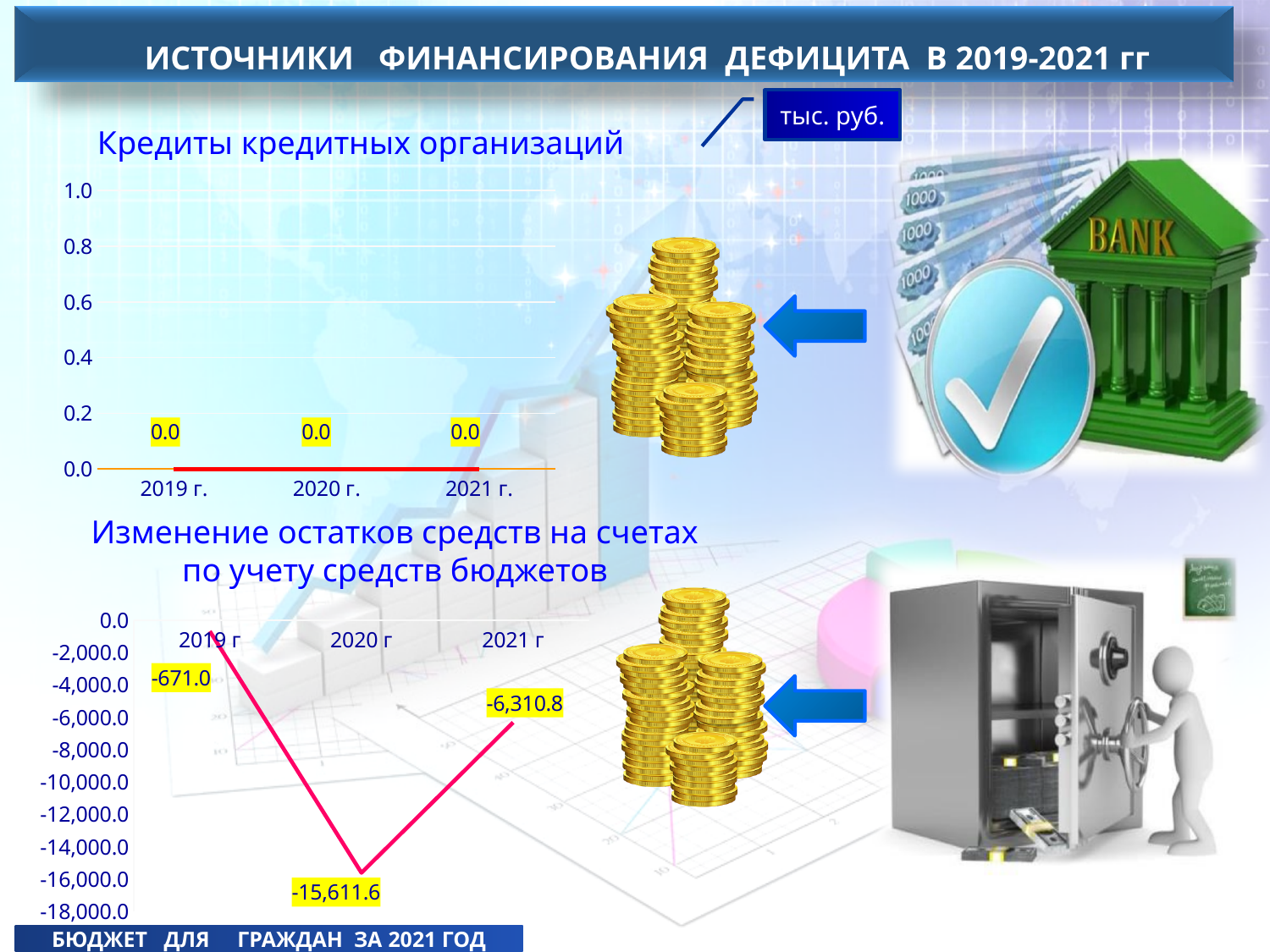
What unit of measurement is indicated for the charts on the slide? тыс. руб. In the chart 'Изменение остатков средств на счетах по учету средств бюджетов', what is the value for 2020 г? -15,611.6 In the chart 'Изменение остатков средств на счетах по учету средств бюджетов', which year has the lowest value? 2020 г In the chart 'Кредиты кредитных организаций', how many years are plotted on the x axis? 3 In the chart 'Изменение остатков средств на счетах по учету средств бюджетов', which year has the highest value? 2019 г In the chart 'Кредиты кредитных организаций', what is the value for 2020 г.? 0.0 In the chart 'Изменение остатков средств на счетах по учету средств бюджетов', what is the value for 2019 г? -671.0 In the chart 'Кредиты кредитных организаций', what is the value for 2021 г.? 0.0 In the chart 'Изменение остатков средств на счетах по учету средств бюджетов', is the value for 2019 г greater or less than the value for 2021 г? greater What kind of chart is 'Кредиты кредитных организаций'? line chart In the chart 'Изменение остатков средств на счетах по учету средств бюджетов', what is the difference between the values for 2021 г and 2020 г? 9,300.8 In the chart 'Изменение остатков средств на счетах по учету средств бюджетов', what is the value for 2021 г? -6,310.8